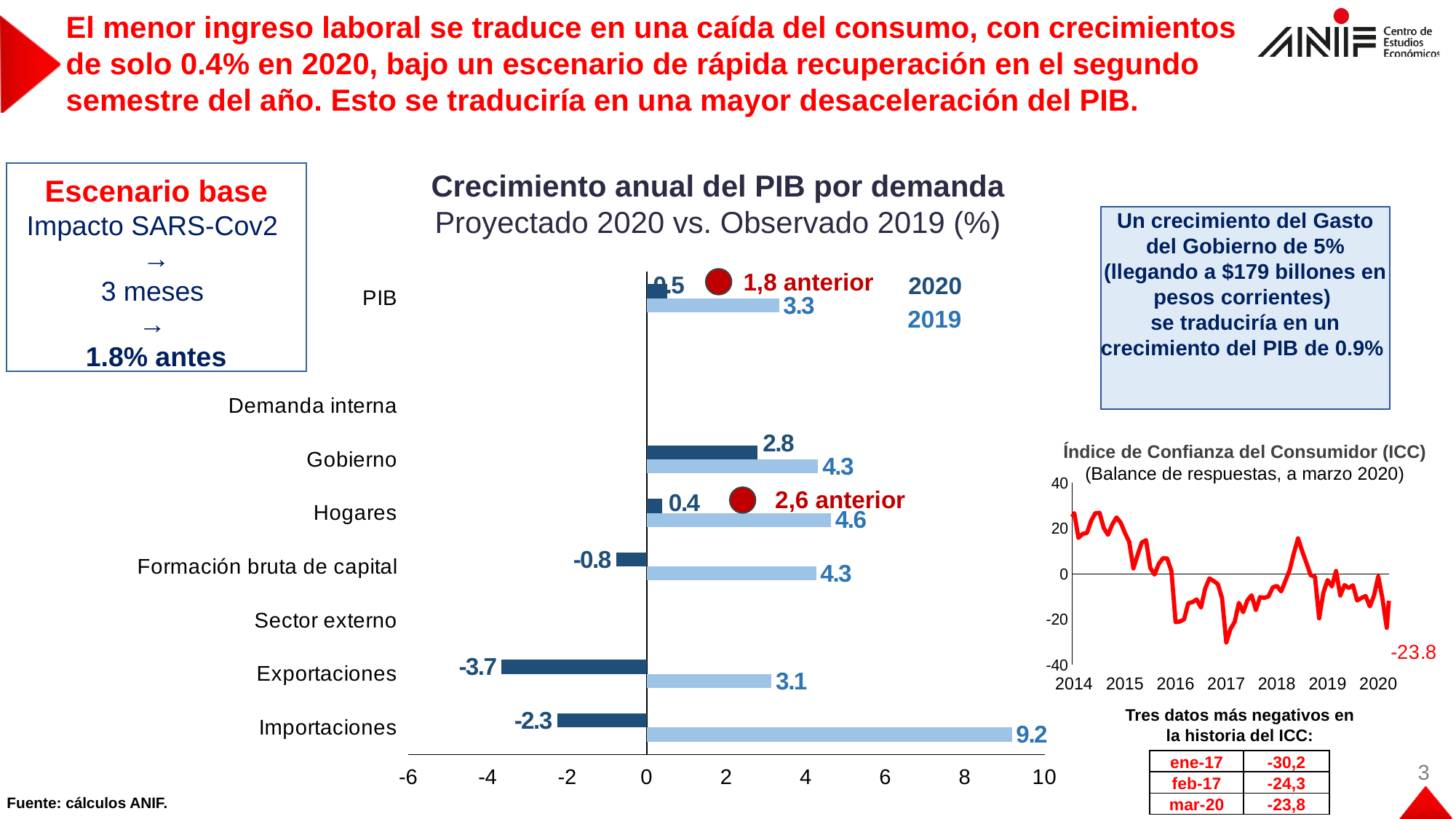
What kind of chart is 'Crecimiento anual del PIB por demanda'? Bar chart In the chart 'Crecimiento anual del PIB por demanda', what is the 2019 value for Importaciones? 9.2 In the chart 'Crecimiento anual del PIB por demanda', what is the 2020 value for Exportaciones? -3.7 In the chart 'Crecimiento anual del PIB por demanda', what is the 2020 value for Hogares? 0.4 What kind of chart is 'Índice de Confianza del Consumidor (ICC)'? Line chart In the chart 'Crecimiento anual del PIB por demanda', which category has the highest 2019 value? Importaciones In the chart 'Crecimiento anual del PIB por demanda', which category has the lowest 2020 value? Exportaciones In the chart 'Crecimiento anual del PIB por demanda', what is the 2019 value for Gobierno? 4.3 In the chart 'Crecimiento anual del PIB por demanda', which is larger: the 2020 value for Gobierno or the 2020 value for PIB? Gobierno In the chart 'Crecimiento anual del PIB por demanda', what is the difference between the 2019 and 2020 values for Hogares? 4.2 In the chart 'Crecimiento anual del PIB por demanda', how many series does the legend list? 2 In the chart 'Índice de Confianza del Consumidor (ICC)', what is the value labelled at the end of the line (March 2020)? -23.8